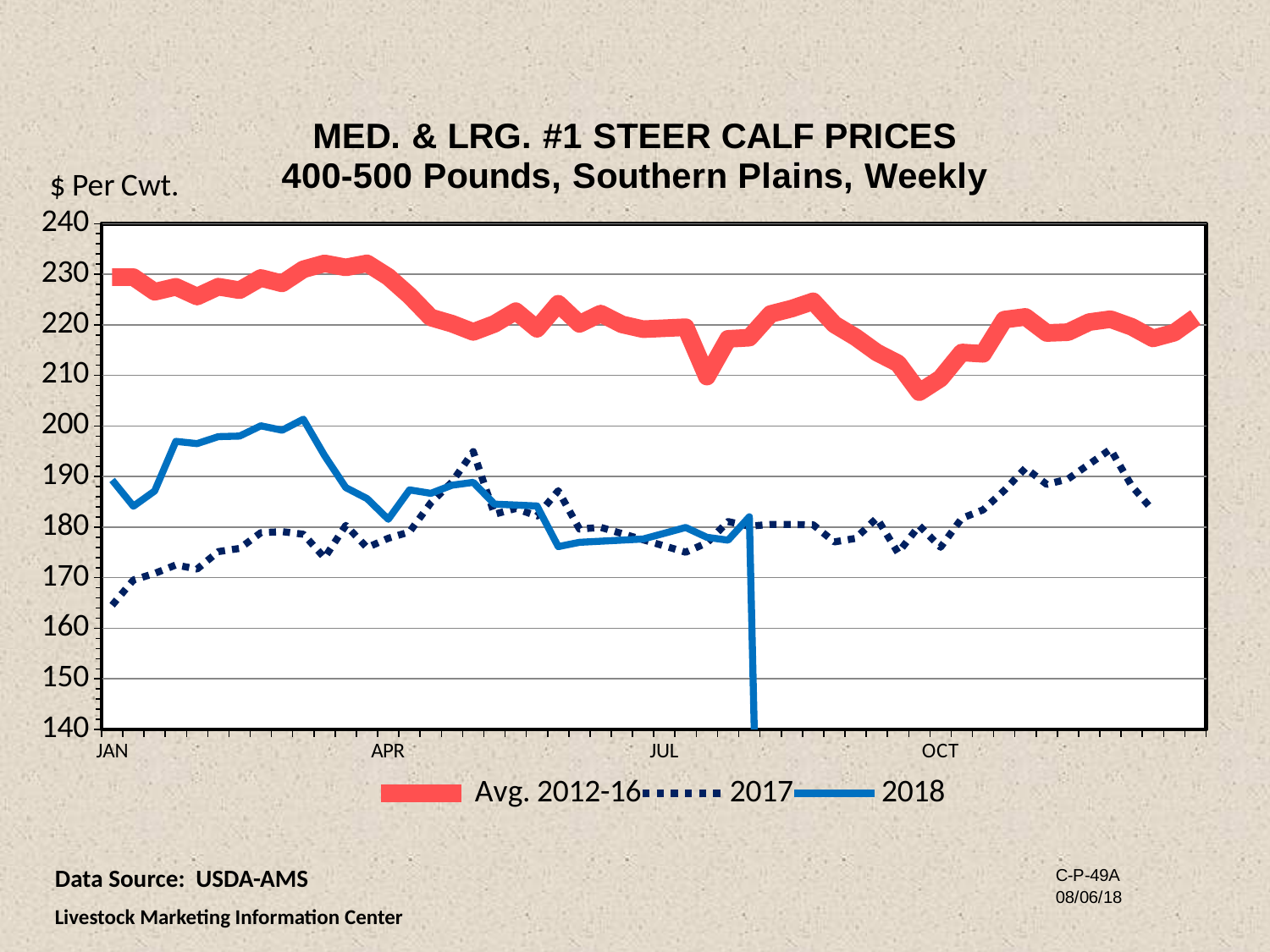
Which series has the highest values across the whole chart? Avg. 2012-16 How many month labels are shown on the x axis? 4 Is the Avg. 2012-16 value at the start of January greater or less than 220? greater What are the three series named in the legend? Avg. 2012-16, 2017, 2018 Which series has the lowest value at the start of January? 2017 At the start of January, which is larger: the Avg. 2012-16 value or the 2018 value? Avg. 2012-16 What unit label is shown above the y axis? $ Per Cwt. Does the 2017 series rise or fall from January to April? rise How many series does the legend list? 3 Is the 2017 value at the start of January greater or less than 170? less Is the 2018 value at the start of January greater or less than 180? greater What kind of chart is shown on the slide? line chart